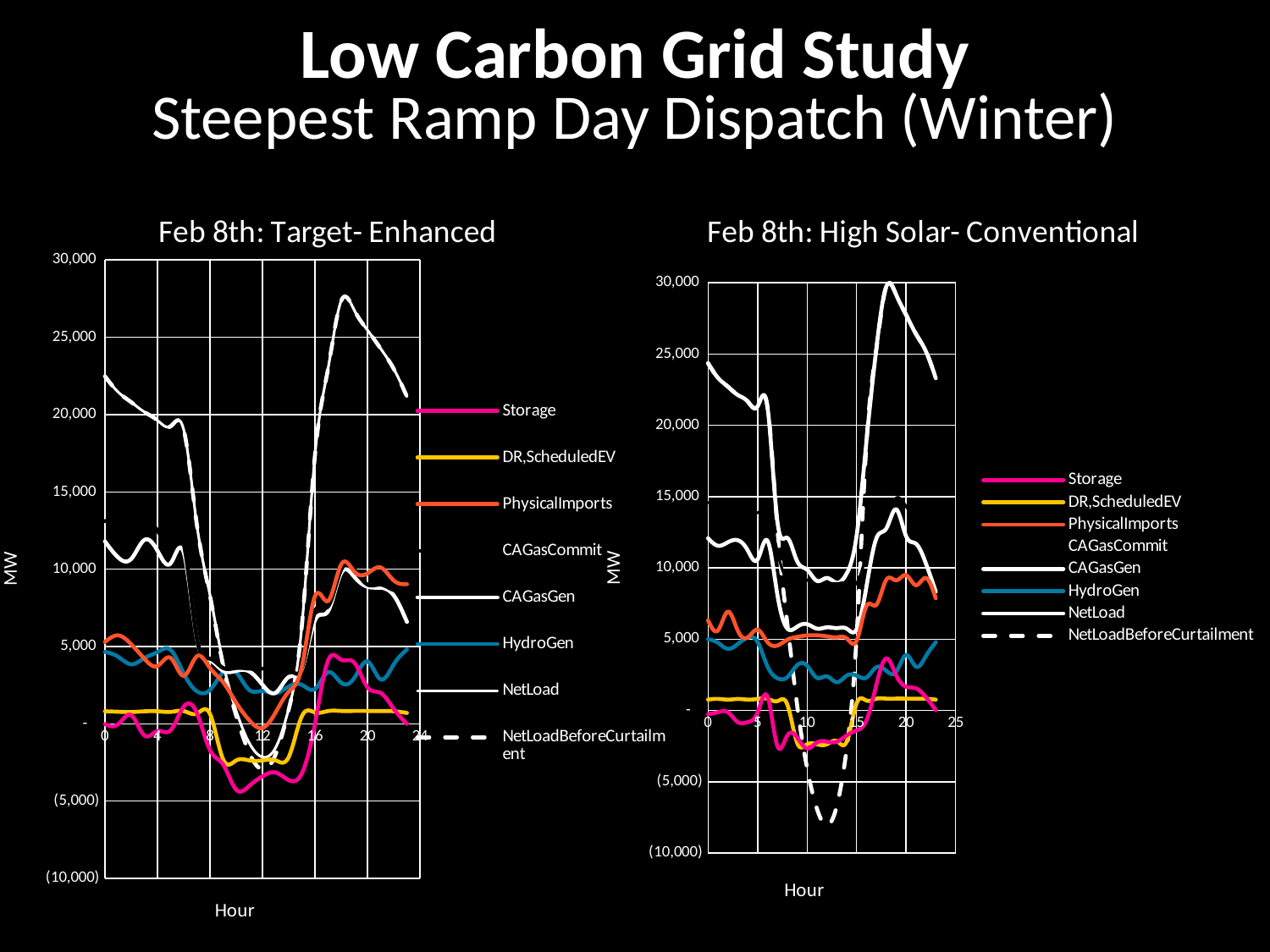
How many series does the legend of the 'Feb 8th: Target- Enhanced' chart list? 8 In the 'Feb 8th: Target- Enhanced' chart, which series has the highest value at hour 0? NetLoad What is the x-axis label on the 'Feb 8th: High Solar- Conventional' chart? Hour How many series does the legend of the 'Feb 8th: High Solar- Conventional' chart list? 8 In the 'Feb 8th: Target- Enhanced' chart, is the peak NetLoad value (around hour 18) greater or less than 25,000? greater In the 'Feb 8th: High Solar- Conventional' chart, is the NetLoad value at hour 0 greater or less than 20,000? greater What type of chart is the 'Feb 8th: Target- Enhanced' chart? Line chart In the 'Feb 8th: High Solar- Conventional' chart, does the NetLoad series rise or fall between hour 15 and hour 19? rise In the 'Feb 8th: Target- Enhanced' chart, does the NetLoad series rise or fall between hour 0 and hour 12? fall In the 'Feb 8th: Target- Enhanced' chart, is the NetLoad value at hour 0 greater or less than 20,000? greater What is the y-axis label on the 'Feb 8th: Target- Enhanced' chart? MW